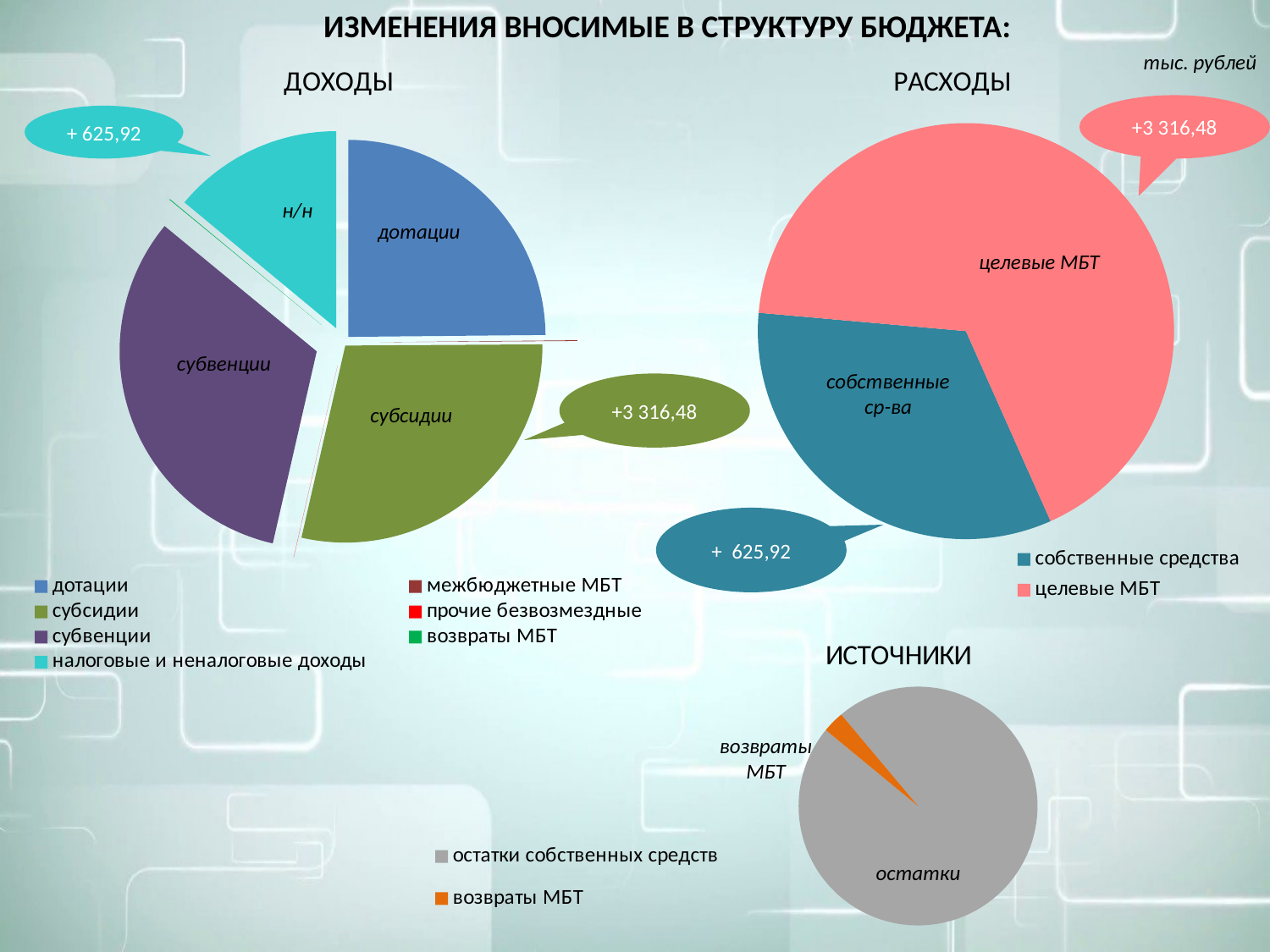
In the ДОХОДЫ chart, what change is shown in the callout pointing to the субсидии slice? +3 316,48 What kind of chart is the ДОХОДЫ chart? pie chart In the ДОХОДЫ chart, which slice is larger: субвенции or н/н? субвенции How many entries does the legend of the ИСТОЧНИКИ chart list? 2 In the РАСХОДЫ chart, what change is shown in the callout pointing to the собственные ср-ва slice? + 625,92 How many entries does the legend of the РАСХОДЫ chart list? 2 What unit is stated for the values on the slide? тыс. рублей In the ИСТОЧНИКИ chart, which slice is the largest? остатки собственных средств In the ИСТОЧНИКИ chart, which slice is the smallest? возвраты МБТ In the РАСХОДЫ chart, which slice is the largest? целевые МБТ How many entries does the legend of the ДОХОДЫ chart list? 7 How many pie charts are shown on the slide? 3